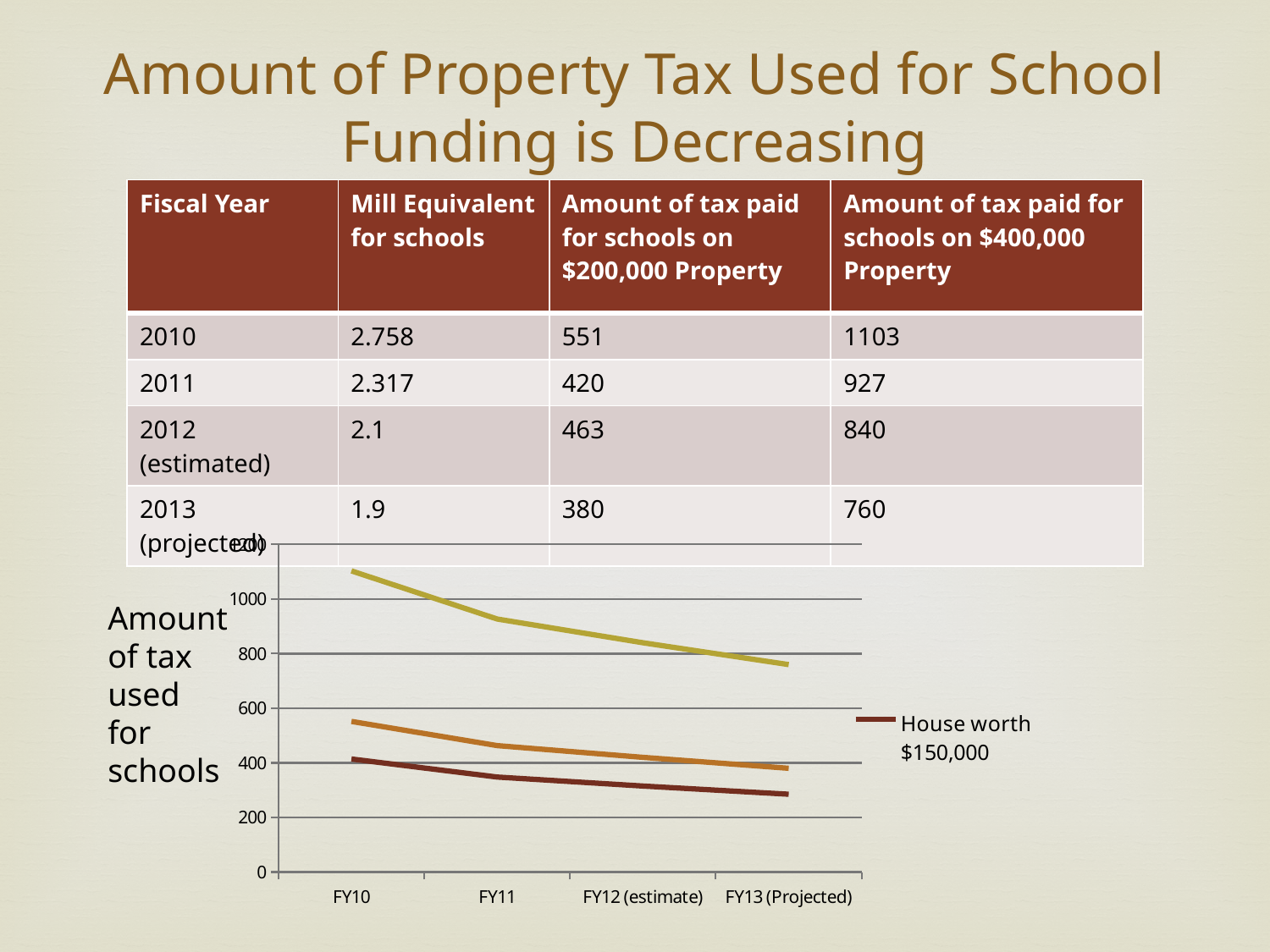
How many fiscal years are plotted along the x axis of the chart? 4 Is the value of the topmost line at FY13 (Projected) greater or less than 800? less At FY10, which is higher: the topmost line or the House worth $150,000 line? the topmost line In which fiscal year is the House worth $150,000 line at its lowest? FY13 (Projected) Is the value of the House worth $150,000 line at FY13 (Projected) greater or less than 400? less What is the label on the vertical axis of the chart? Amount of tax used for schools What kind of chart is shown on the slide? line chart Is the value of the topmost line at FY10 greater or less than 1000? greater How many series does the chart's legend list? 1 In which fiscal year is the House worth $150,000 line at its highest? FY10 Do the lines in the chart rise or fall from FY10 to FY13 (Projected)? fall What is the legend entry shown on the chart? House worth $150,000